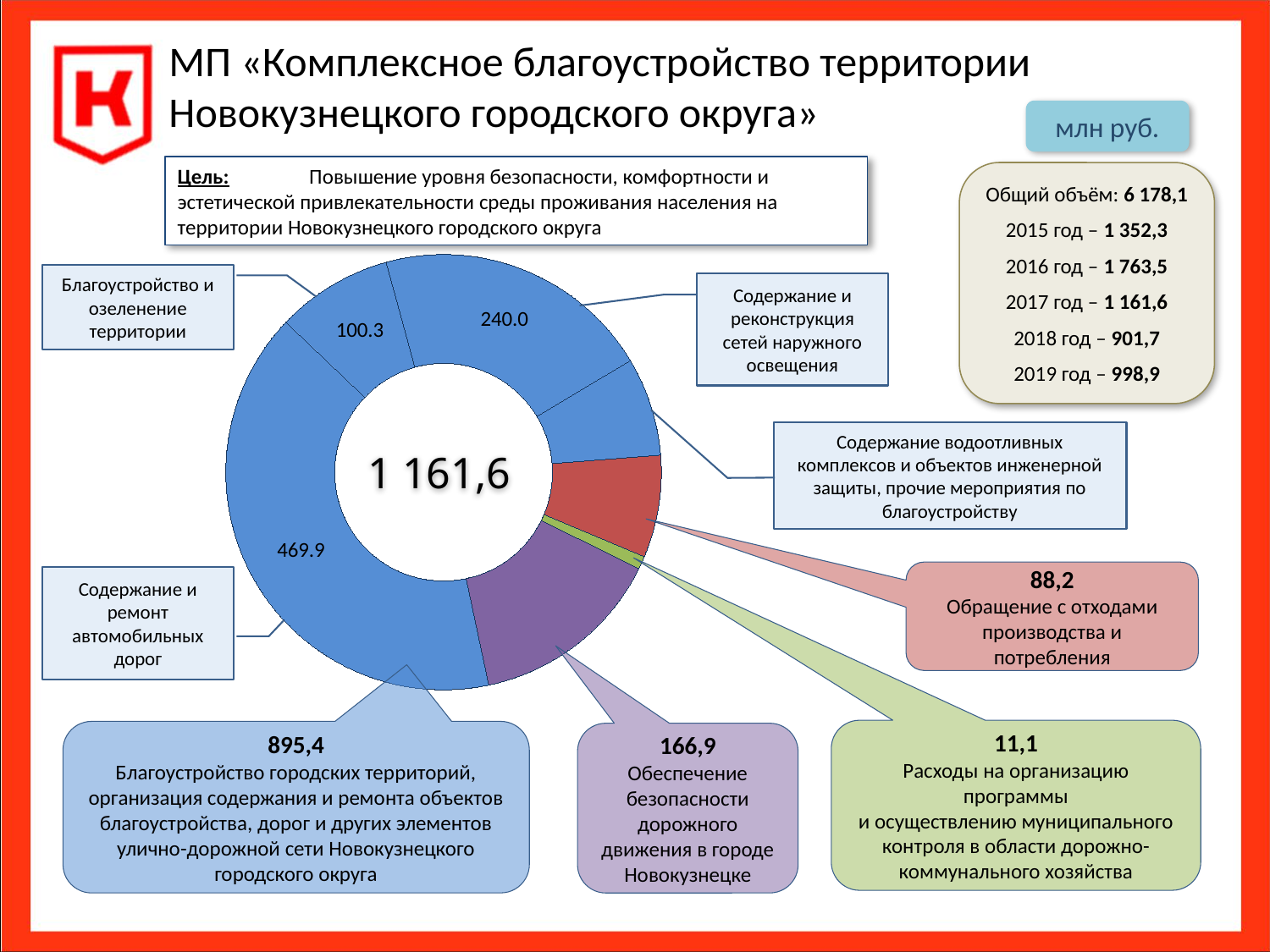
Which is larger: the segment for "Содержание и реконструкция сетей наружного освещения" or the segment for "Благоустройство и озеленение территории"? Содержание и реконструкция сетей наружного освещения What value is shown for the segment labelled "Содержание и ремонт автомобильных дорог"? 469.9 What kind of chart is shown on the slide? Doughnut (pie) chart What total value is printed in the centre of the chart? 1 161,6 What value is given for "Расходы на организацию программы и осуществлению муниципального контроля в области дорожно-коммунального хозяйства"? 11,1 Which segment of the chart is the largest? Содержание и ремонт автомобильных дорог What value is shown for the segment "Содержание и реконструкция сетей наружного освещения"? 240.0 What is the difference between the value for "Содержание и ремонт автомобильных дорог" and the value for "Содержание и реконструкция сетей наружного освещения"? 229.9 What value is given for "Обращение с отходами производства и потребления"? 88,2 What value is given for "Обеспечение безопасности дорожного движения в городе Новокузнецке"? 166,9 What value is shown for the segment "Благоустройство и озеленение территории"? 100.3 Which segment of the chart is the smallest? Расходы на организацию программы и осуществлению муниципального контроля в области дорожно-коммунального хозяйства